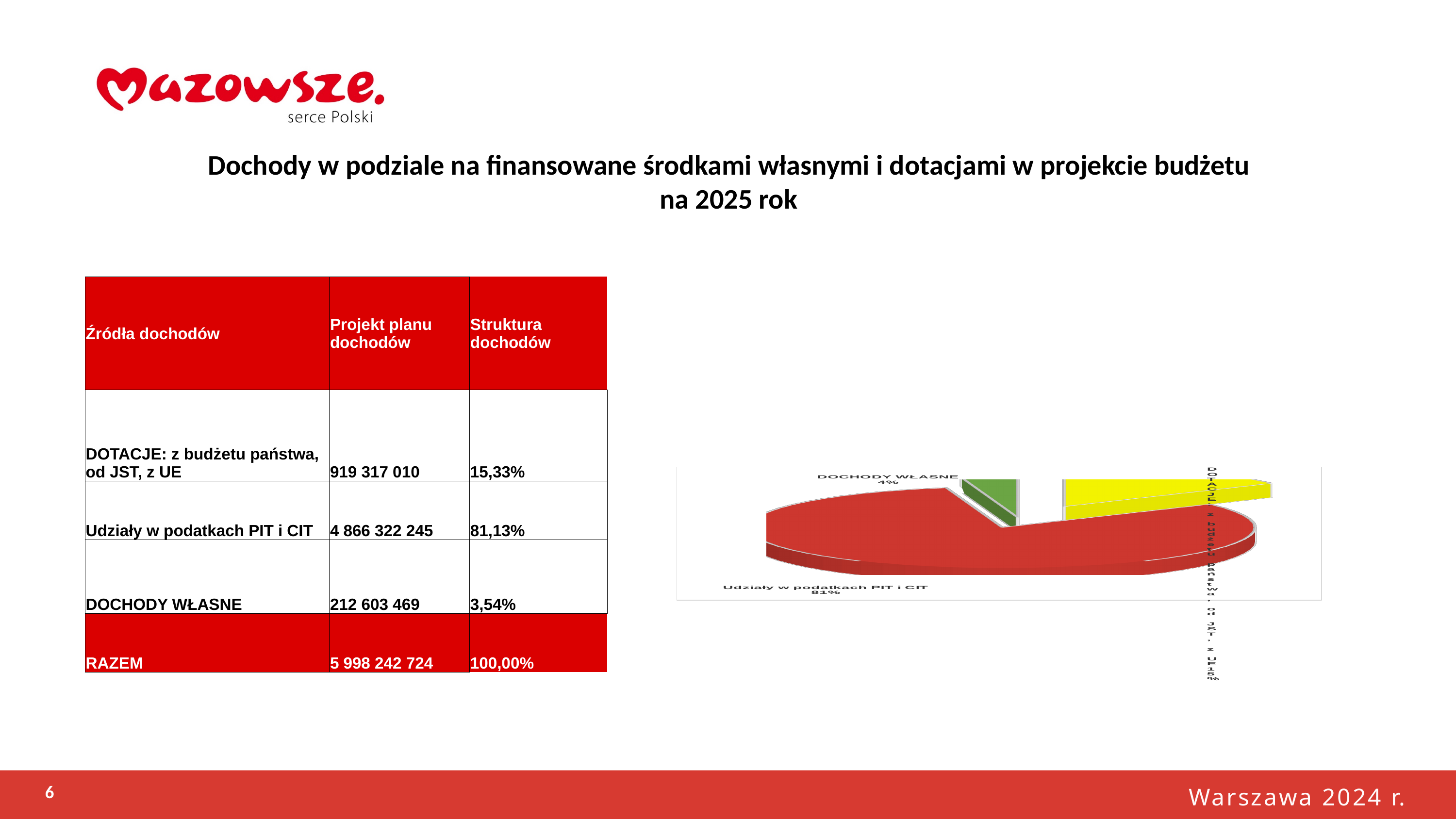
Which slice of the pie chart is the smallest? DOCHODY WŁASNE In the pie chart, which is larger: the 'DOCHODY WŁASNE' slice or the 'Udziały w podatkach PIT i CIT' slice? Udziały w podatkach PIT i CIT What share of the pie does the slice for 'DOTACJE: z budżetu państwa, od JST, z UE' represent? 15% What share of the pie does the slice labelled 'DOCHODY WŁASNE' represent? 4% What share of the pie does the slice labelled 'Udziały w podatkach PIT i CIT' represent? 81% What colour is the 'DOCHODY WŁASNE' slice in the pie chart? green What is the difference in percentage points between the 'Udziały w podatkach PIT i CIT' slice and the 'DOCHODY WŁASNE' slice in the pie chart? 77 What kind of chart is shown on the right of the slide? pie chart How many slices does the pie chart have? 3 Which slice of the pie chart is the largest? Udziały w podatkach PIT i CIT What colour is the 'Udziały w podatkach PIT i CIT' slice in the pie chart? red